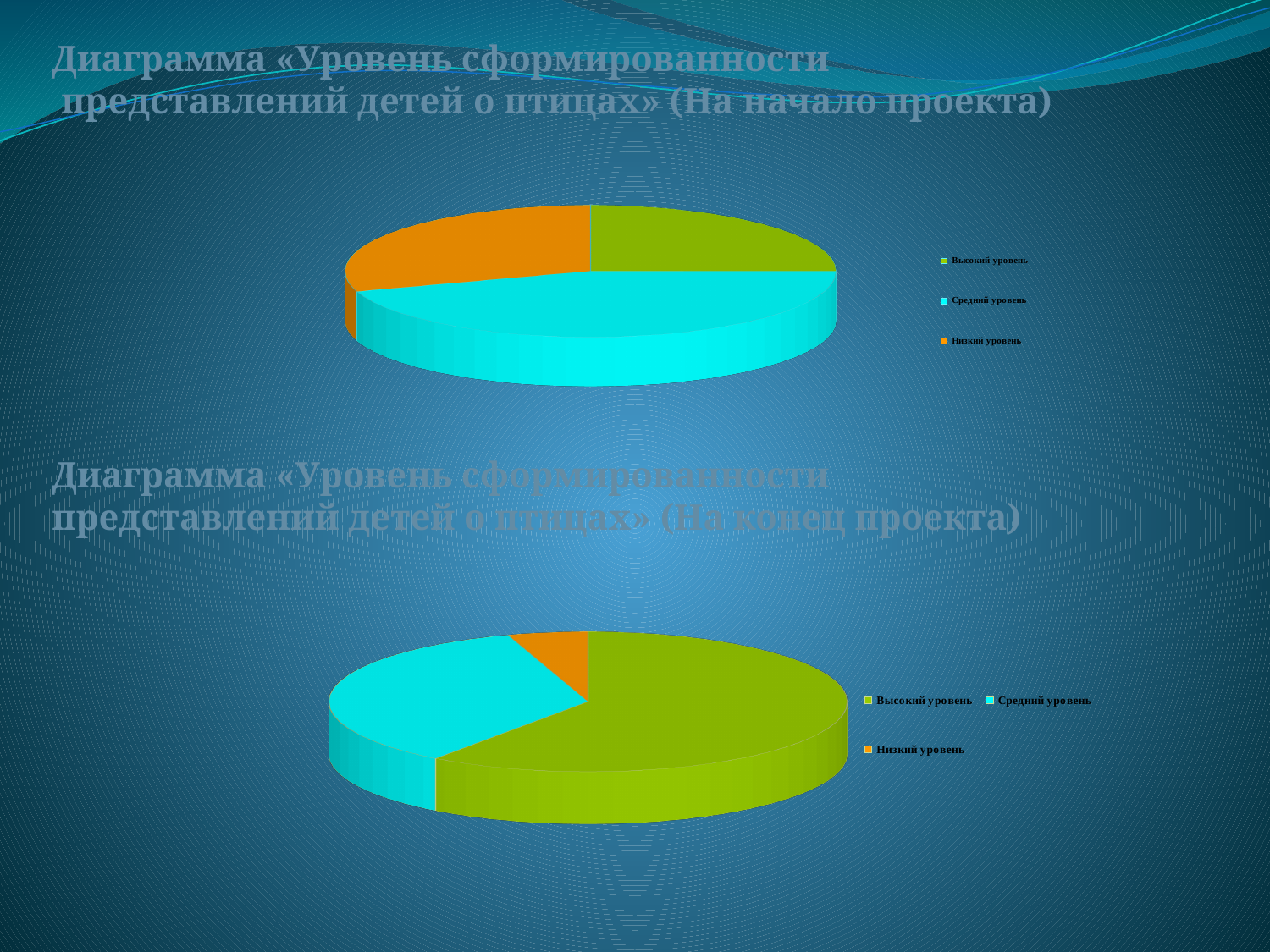
What kind of chart is shown under the title «На начало проекта»? Pie chart In the top chart (На начало проекта), which slice is larger: Средний уровень or Высокий уровень? Средний уровень What kind of chart is shown under the title «На конец проекта»? Pie chart In the bottom chart (На конец проекта), which level has the largest slice? Высокий уровень In the bottom chart (На конец проекта), which slice is larger: Высокий уровень or Средний уровень? Высокий уровень In the top chart (На начало проекта), what colour represents Низкий уровень? Orange In the bottom chart (На конец проекта), which slice is larger: Средний уровень or Низкий уровень? Средний уровень In the top chart (На начало проекта), which level has the largest slice? Средний уровень How many entries does the legend of the bottom chart (На конец проекта) list? 3 In the bottom chart (На конец проекта), what colour represents Высокий уровень? Green How many slices does the top chart (На начало проекта) have? 3 In the bottom chart (На конец проекта), which level has the smallest slice? Низкий уровень